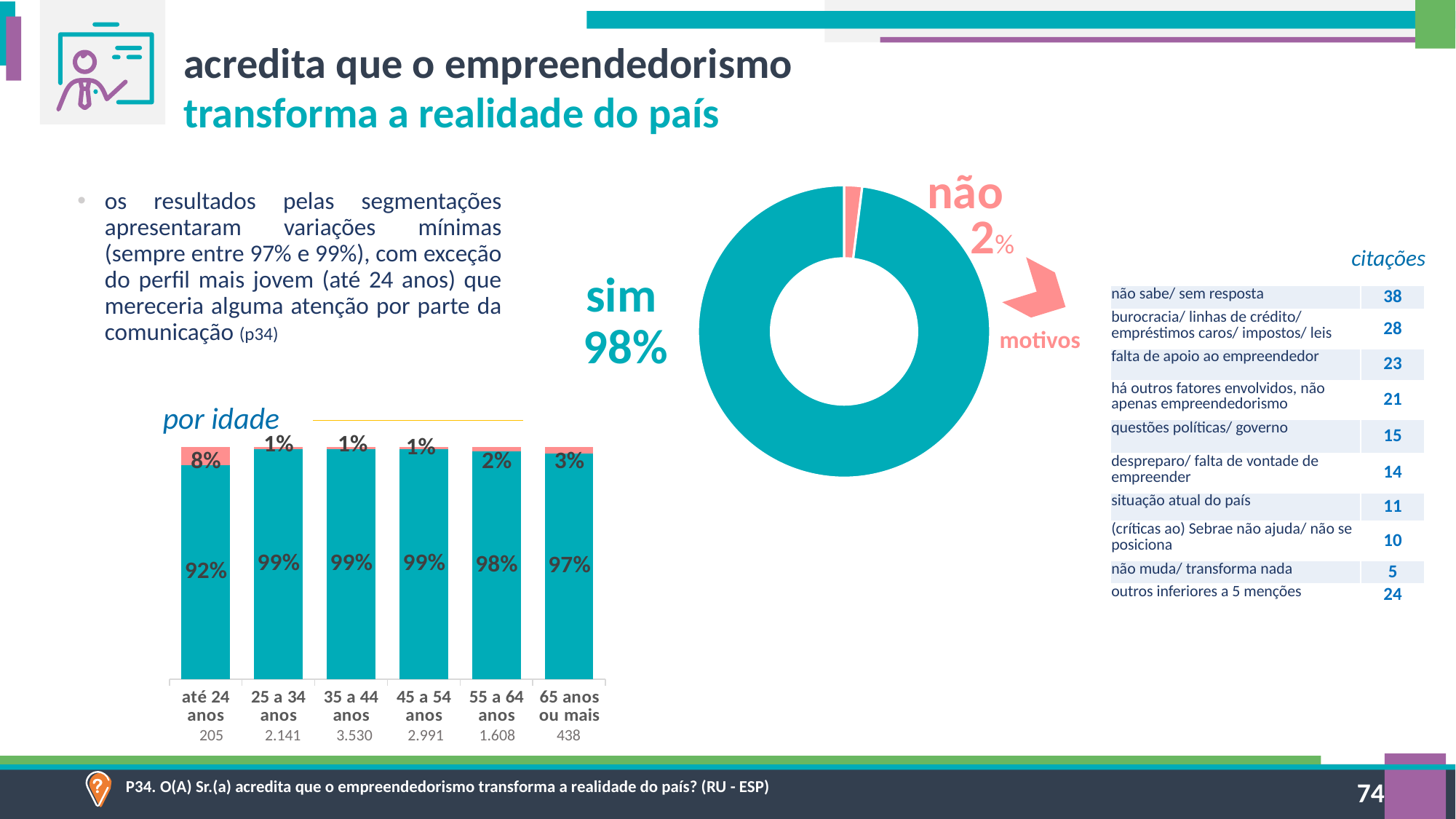
In the "por idade" bar chart, is the "sim" percentage larger for "55 a 64 anos" or for "65 anos ou mais"? 55 a 64 anos In the donut chart, what percentage answered "sim"? 98% In the "por idade" bar chart, which age group has the highest "não" percentage? até 24 anos In the "por idade" bar chart, which age group has the lowest "sim" percentage? até 24 anos In the "por idade" bar chart, what is the difference between the "sim" percentage for "25 a 34 anos" and for "até 24 anos"? 7% What kind of chart shows the overall "sim" and "não" split? Donut chart In the donut chart, what percentage answered "não"? 2% In the "por idade" bar chart, what is the total of the stacked bar for "35 a 44 anos"? 100% In the "por idade" bar chart, how many age groups are shown? 6 In the "por idade" bar chart, what is the "sim" percentage for the "até 24 anos" group? 92% In the "por idade" bar chart, what is the "não" percentage for the "65 anos ou mais" group? 3% What kind of chart is the "por idade" chart? Stacked bar chart